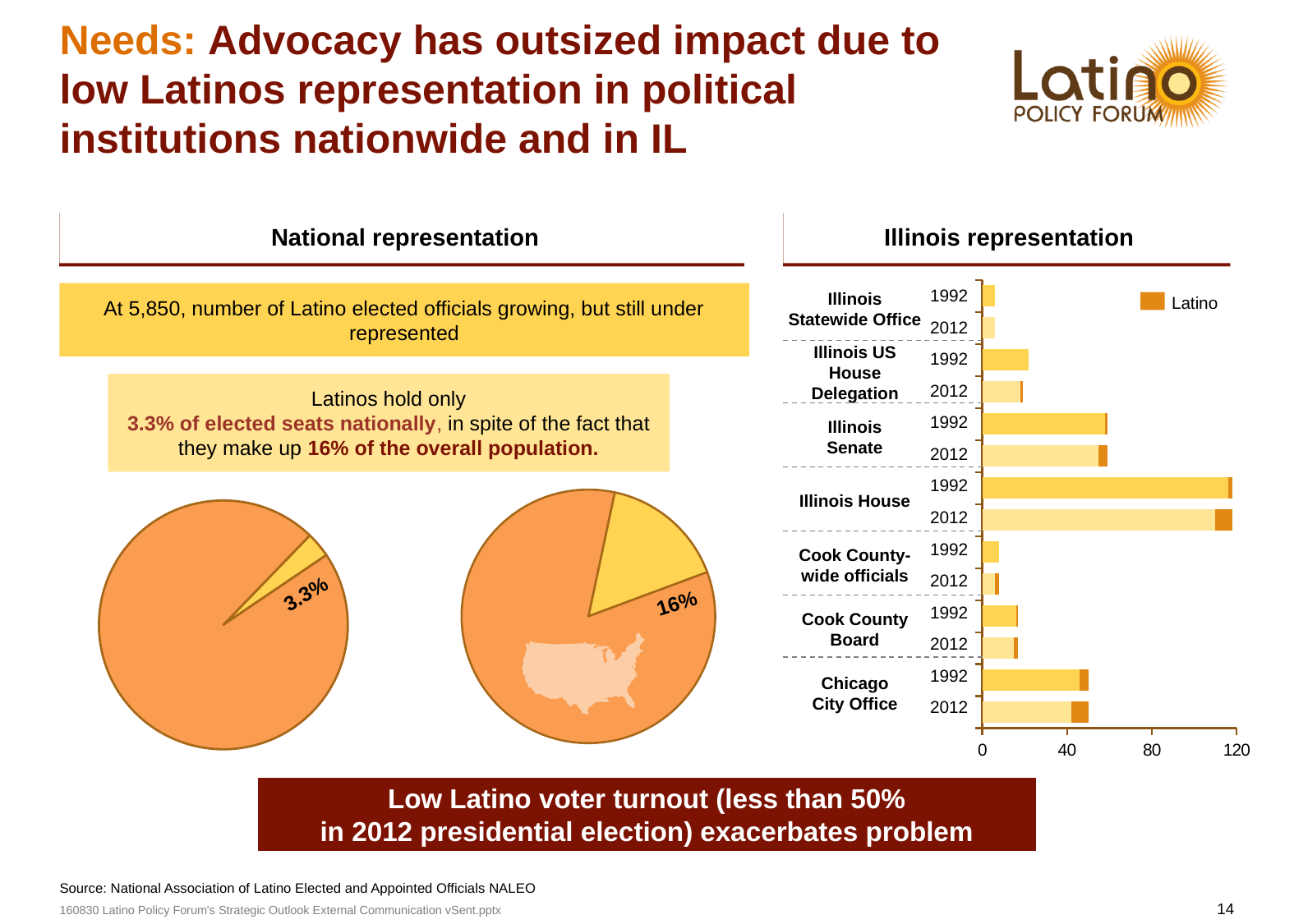
In the left pie chart under 'National representation', what share does the highlighted slice represent? 3.3% In the 'Illinois representation' chart, is the 1992 bar for Illinois Senate greater or less than 40? greater In the right pie chart under 'National representation', what share does the highlighted slice represent? 16% In the 'Illinois representation' chart, which is larger: the 2012 bar for Illinois Senate or the 2012 bar for Cook County Board? Illinois Senate What kind of chart is the 'Illinois representation' chart? bar chart In the 'Illinois representation' chart, is the 1992 bar for Cook County Board greater or less than 40? less In the 'Illinois representation' chart, which institution has the shortest bars? Illinois Statewide Office In the 'Illinois representation' chart, which institution has the longest bars? Illinois House In the 'Illinois representation' chart, what is the legend entry? Latino In the 'Illinois representation' chart, is the 1992 bar for Illinois House greater or less than 80? greater In the 'Illinois representation' chart, how many entries does the legend list? 1 In the 'Illinois representation' chart, how many institutions (categories) are listed on the vertical axis? 7